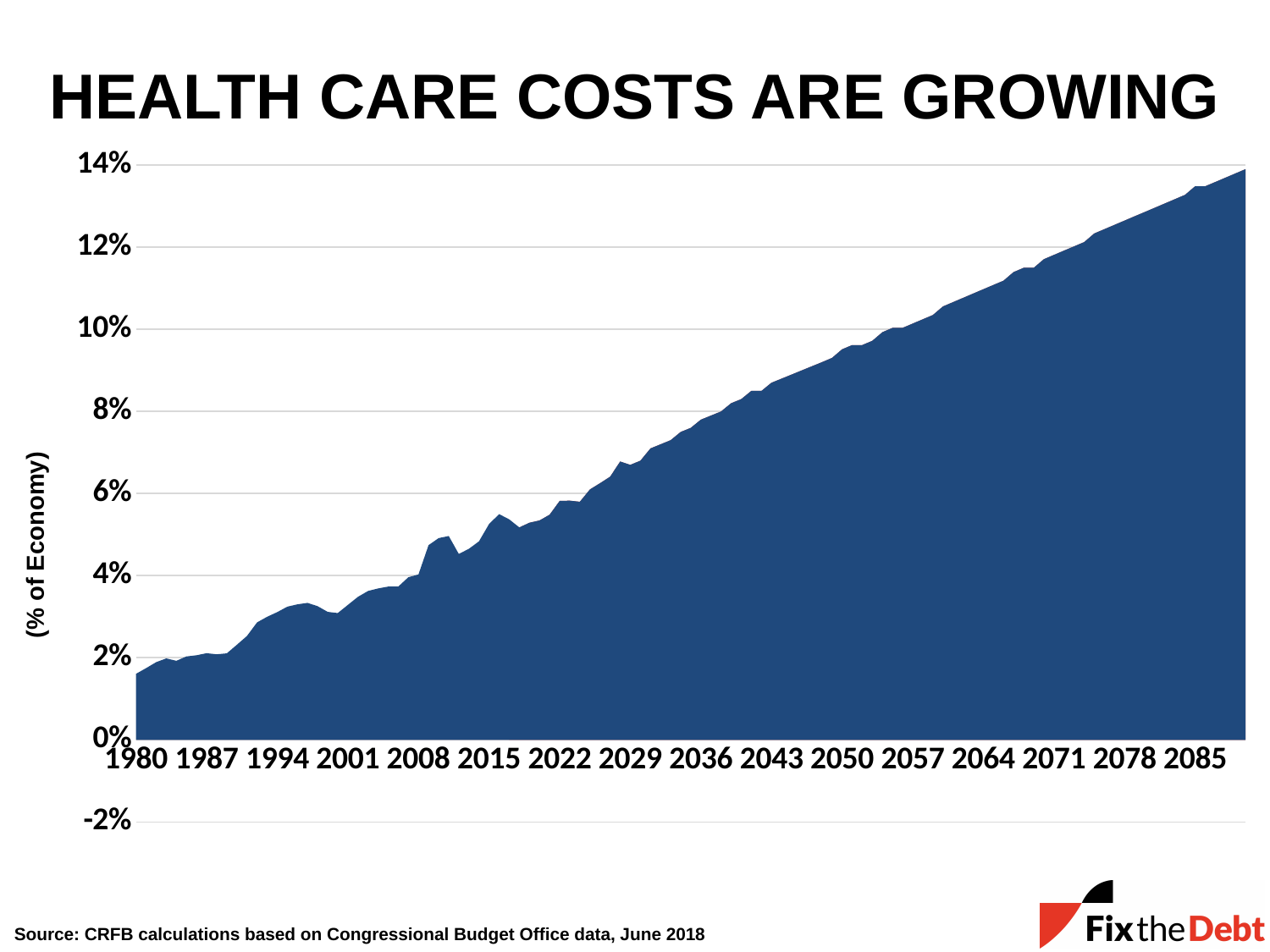
Which year shown has the lowest value? 1980 What is the label on the vertical axis? (% of Economy) Is the value for 1980 greater or less than 2%? less What is the title of the chart? HEALTH CARE COSTS ARE GROWING Is the value for 2050 greater or less than 8%? greater Is the value for 2064 greater or less than 10%? greater Do health care costs as a share of the economy rise or fall from 1980 to 2085? Rise What kind of chart is shown on the slide? Area chart